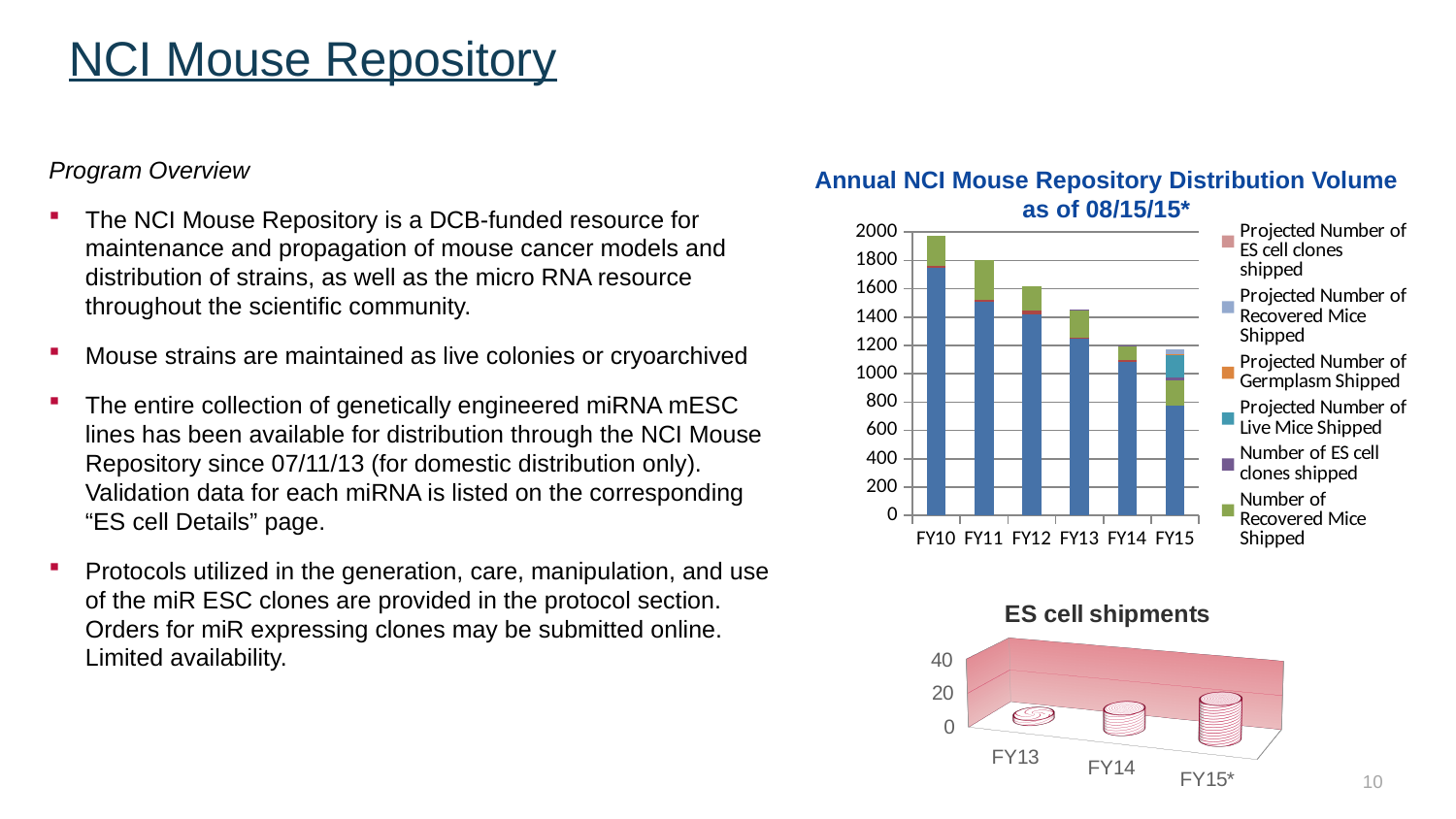
In the 'Annual NCI Mouse Repository Distribution Volume' chart, which fiscal year has the tallest stacked bar? FY10 How many fiscal years are shown on the x axis of the 'Annual NCI Mouse Repository Distribution Volume' chart? 6 What is the title of the lower chart on the slide? ES cell shipments How many series does the legend of the 'Annual NCI Mouse Repository Distribution Volume' chart list? 6 What kind of chart is the 'Annual NCI Mouse Repository Distribution Volume as of 08/15/15*' chart? Stacked bar chart In the 'Annual NCI Mouse Repository Distribution Volume' chart, which is taller overall, the FY11 bar or the FY13 bar? FY11 In the 'Annual NCI Mouse Repository Distribution Volume' chart, is the total stacked bar for FY14 greater or less than 1400? less In the 'ES cell shipments' chart, is the value for FY13 greater or less than 20? less In the 'Annual NCI Mouse Repository Distribution Volume' chart, do the total bar heights generally rise or fall from FY10 to FY15? Fall In the 'Annual NCI Mouse Repository Distribution Volume' chart, is the total stacked bar for FY13 greater or less than 1600? less In the 'ES cell shipments' chart, which fiscal year has the highest value? FY15*